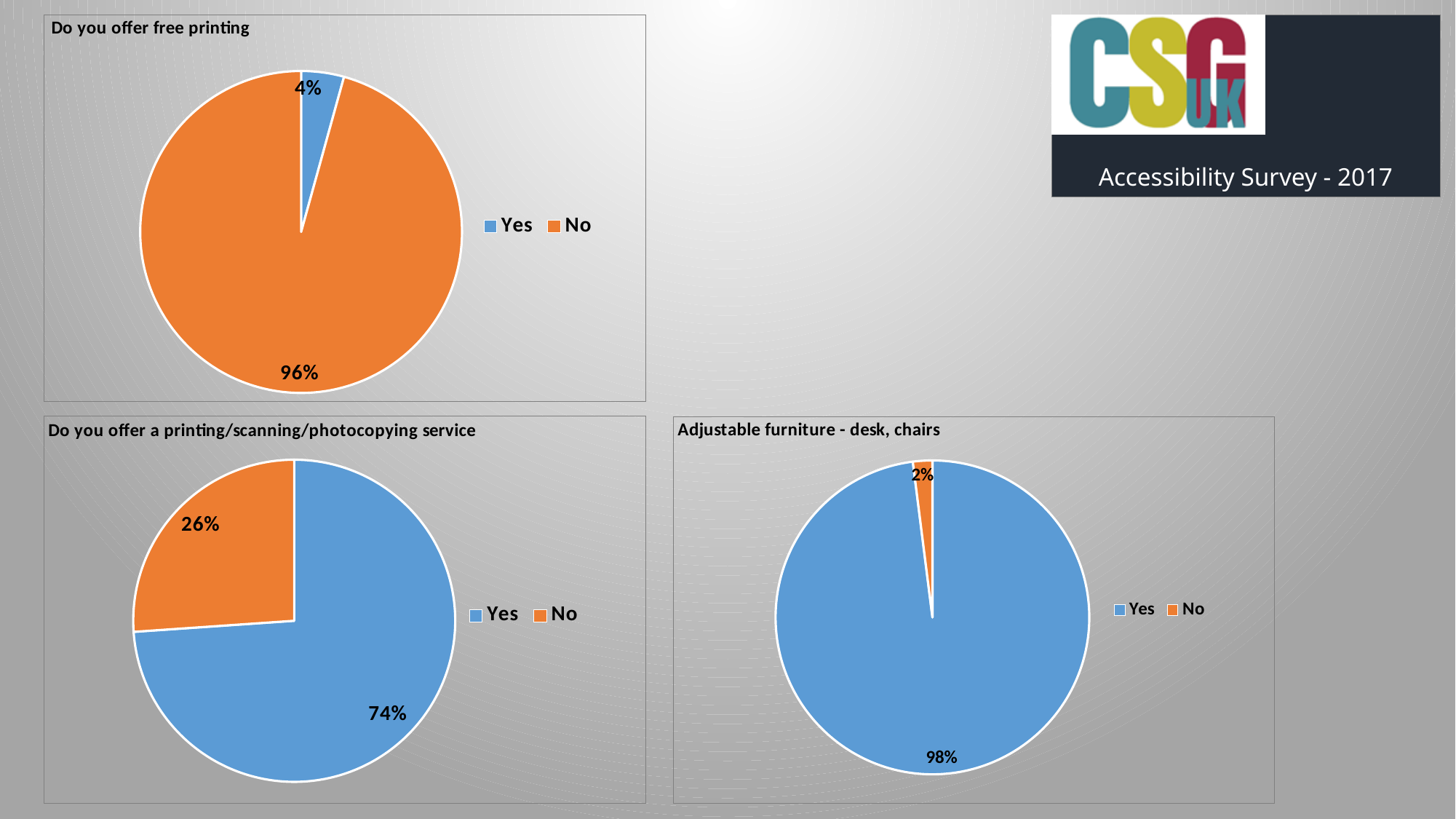
Which colour represents 'No' in the 'Do you offer a printing/scanning/photocopying service' chart? Orange In the 'Do you offer free printing' chart, what percentage answered Yes? 4% In the 'Adjustable furniture - desk, chairs' chart, what percentage answered Yes? 98% In the 'Adjustable furniture - desk, chairs' chart, what percentage answered No? 2% How many categories does the legend of the 'Adjustable furniture - desk, chairs' chart list? 2 In the 'Do you offer a printing/scanning/photocopying service' chart, what percentage answered No? 26% In the 'Do you offer free printing' chart, what percentage answered No? 96% What type of chart is 'Do you offer free printing'? Pie chart In the 'Adjustable furniture - desk, chairs' chart, which response has the smaller share? No In the 'Do you offer a printing/scanning/photocopying service' chart, what percentage answered Yes? 74% In the 'Do you offer a printing/scanning/photocopying service' chart, what is the difference in percentage points between Yes and No? 48 In the 'Do you offer free printing' chart, which response has the larger share? No